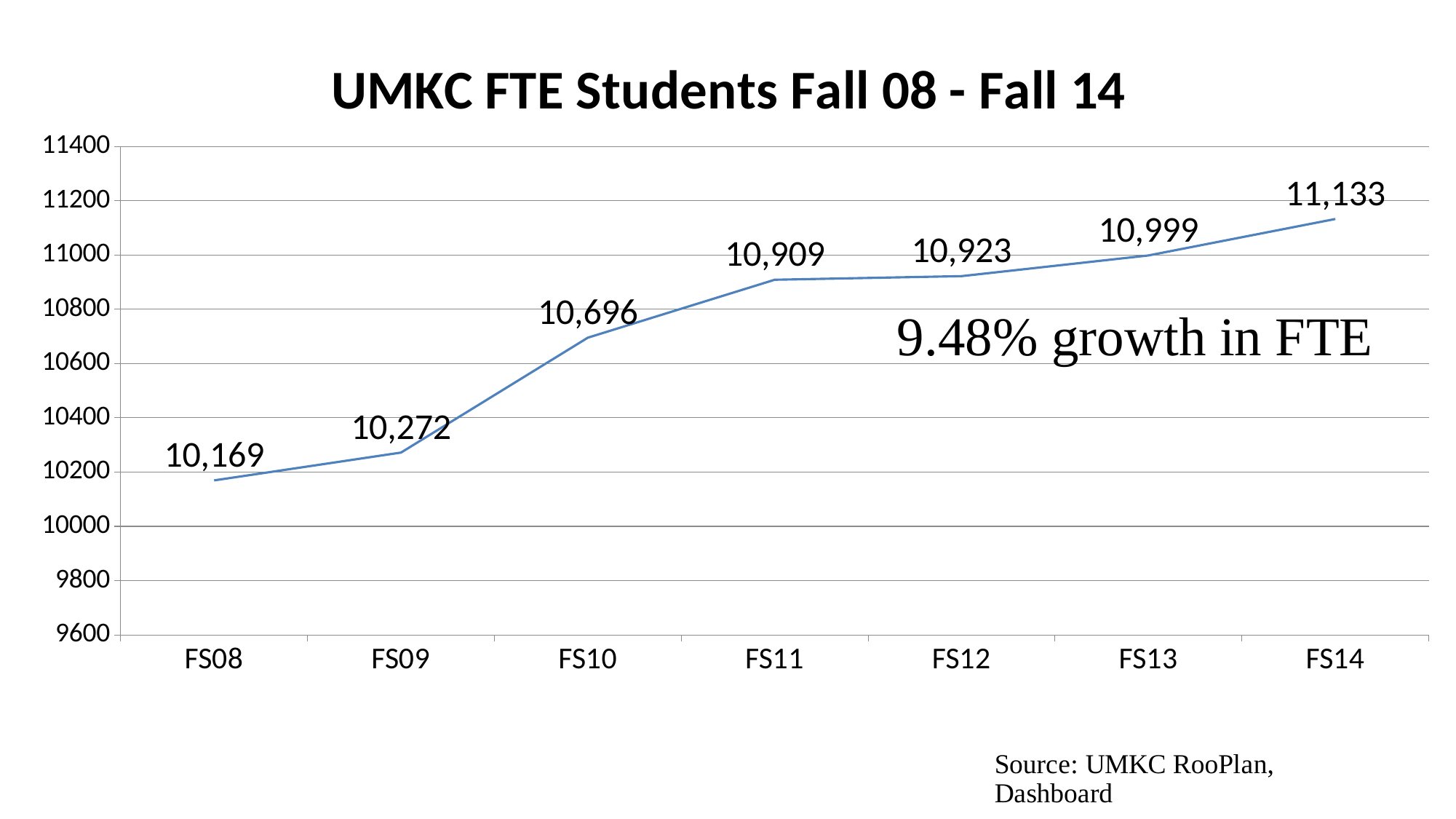
Which is larger, the FTE value for FS12 or FS13? FS13 Which term has the lowest FTE student value? FS08 What kind of chart is shown on the slide? line chart Do the FTE values rise or fall from FS08 to FS14? rise Which term has the highest FTE student value? FS14 Is the value for FS10 greater or less than 10600? greater What is the FTE student value for FS11? 10,909 What is the difference in FTE students between FS14 and FS08? 964 What is the FTE student value for FS08? 10,169 How many terms are plotted on the x axis? 7 What is the FTE student value for FS14? 11,133 What is the difference in FTE students between FS10 and FS09? 424